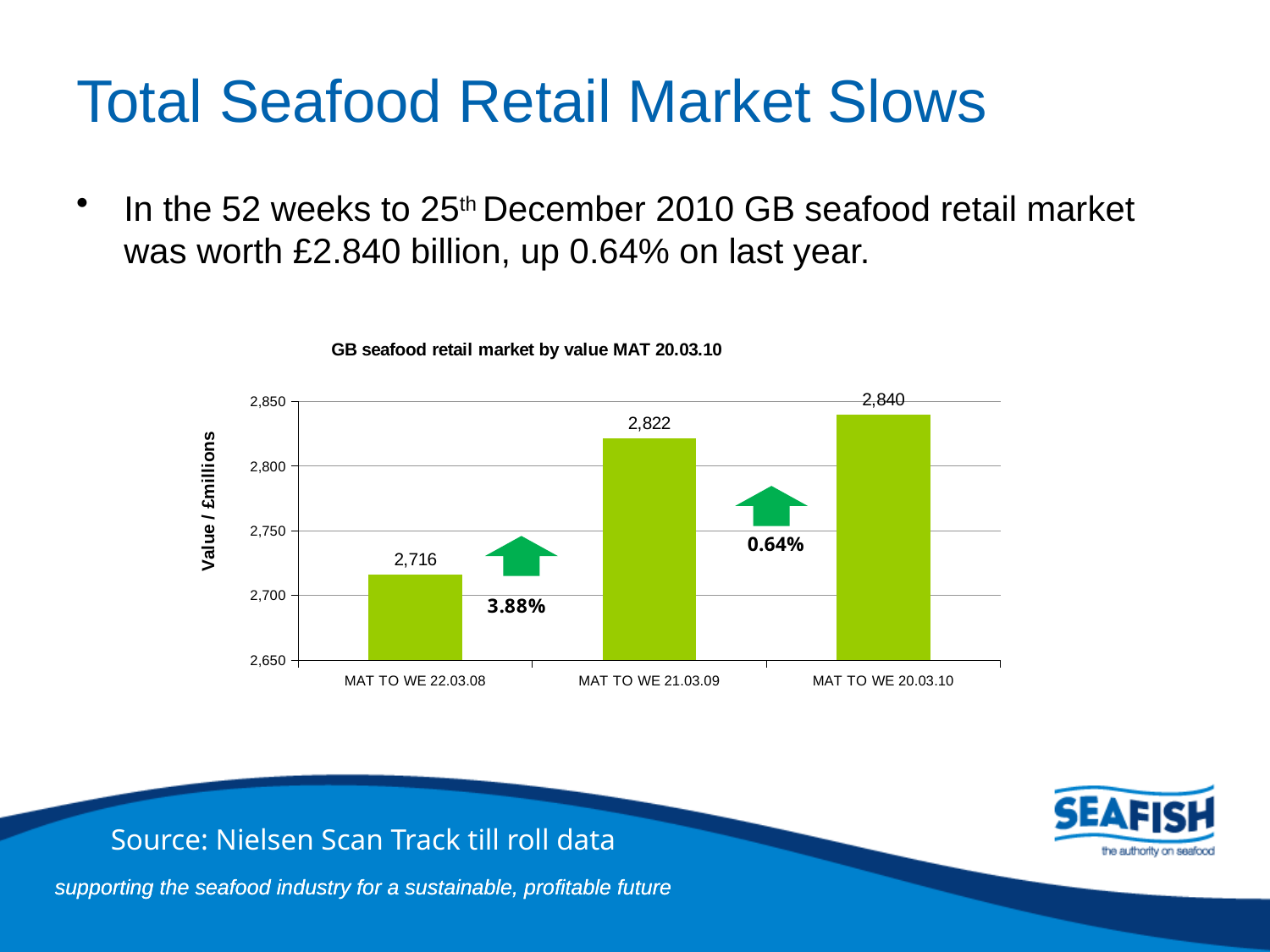
What is the difference between the values for MAT TO WE 21.03.09 and MAT TO WE 22.03.08? 106 What is the value for MAT TO WE 22.03.08? 2,716 What is the difference between the values for MAT TO WE 20.03.10 and MAT TO WE 21.03.09? 18 Which category has the lowest value? MAT TO WE 22.03.08 What is the value for MAT TO WE 20.03.10? 2,840 Which category has the highest value? MAT TO WE 20.03.10 What is the value for MAT TO WE 21.03.09? 2,822 Do the values rise or fall from left to right across the x axis? rise What kind of chart is shown on the slide? bar chart Is the value for MAT TO WE 22.03.08 greater or less than 2,750? less Which is larger, the value for MAT TO WE 22.03.08 or MAT TO WE 21.03.09? MAT TO WE 21.03.09 How many bars are shown in the chart? 3